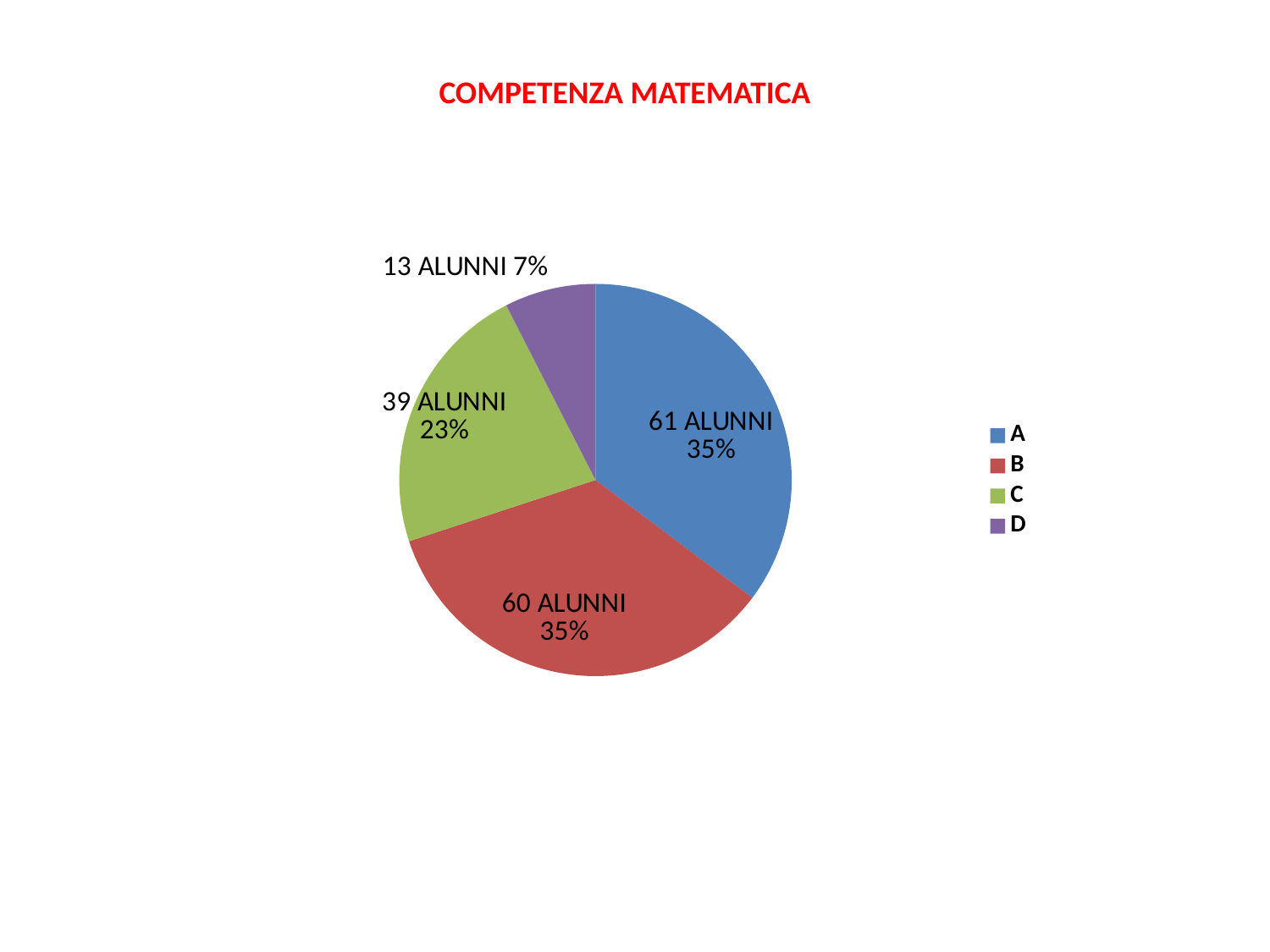
Which category has the largest number of alunni? A What is the title of the chart? COMPETENZA MATEMATICA Which has more alunni, category C or category D? C What kind of chart is shown on the slide? pie chart How many alunni are in category C? 39 ALUNNI How many alunni are in category A? 61 ALUNNI What percentage share does category B have? 35% What percentage share does category D have? 7% Which category has the smallest slice? D How many slices does the pie chart have? 4 How many entries does the legend list? 4 What is the difference in alunni between category B and category C? 21